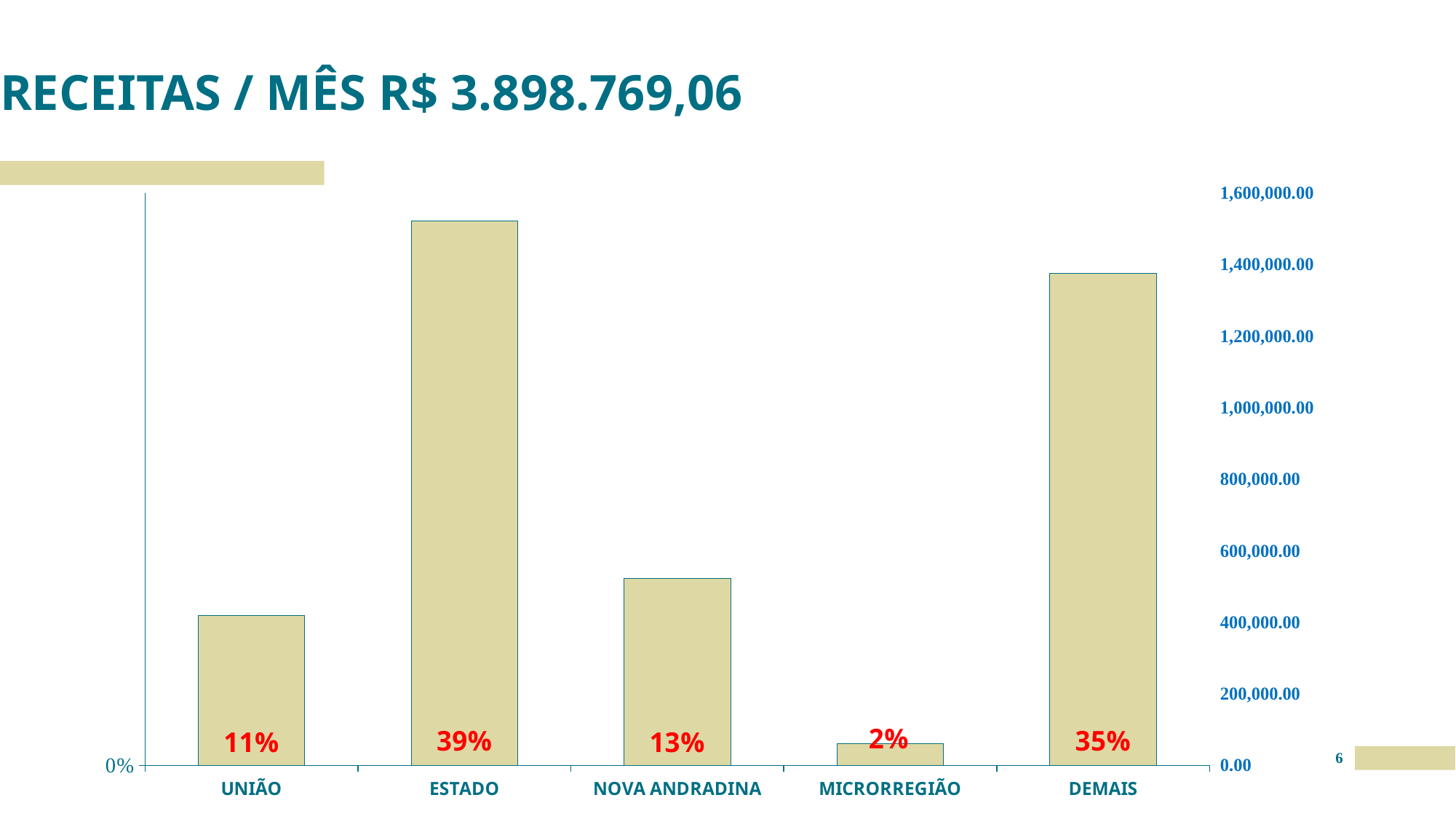
What kind of chart is shown on the slide? Bar chart What is the difference in percentage points between the ESTADO label and the UNIÃO label? 28% Which category has the highest bar? ESTADO What percentage label is shown on the ESTADO bar? 39% What percentage label is shown on the DEMAIS bar? 35% How many categories are shown on the x axis? 5 What percentage label is shown on the UNIÃO bar? 11% What percentage label is shown on the MICRORREGIÃO bar? 2% Which bar is taller, NOVA ANDRADINA or UNIÃO? NOVA ANDRADINA Is the value for ESTADO on the right-hand axis greater or less than 1,400,000.00? greater Which category has the lowest bar? MICRORREGIÃO Is the value for NOVA ANDRADINA on the right-hand axis greater or less than 600,000.00? less